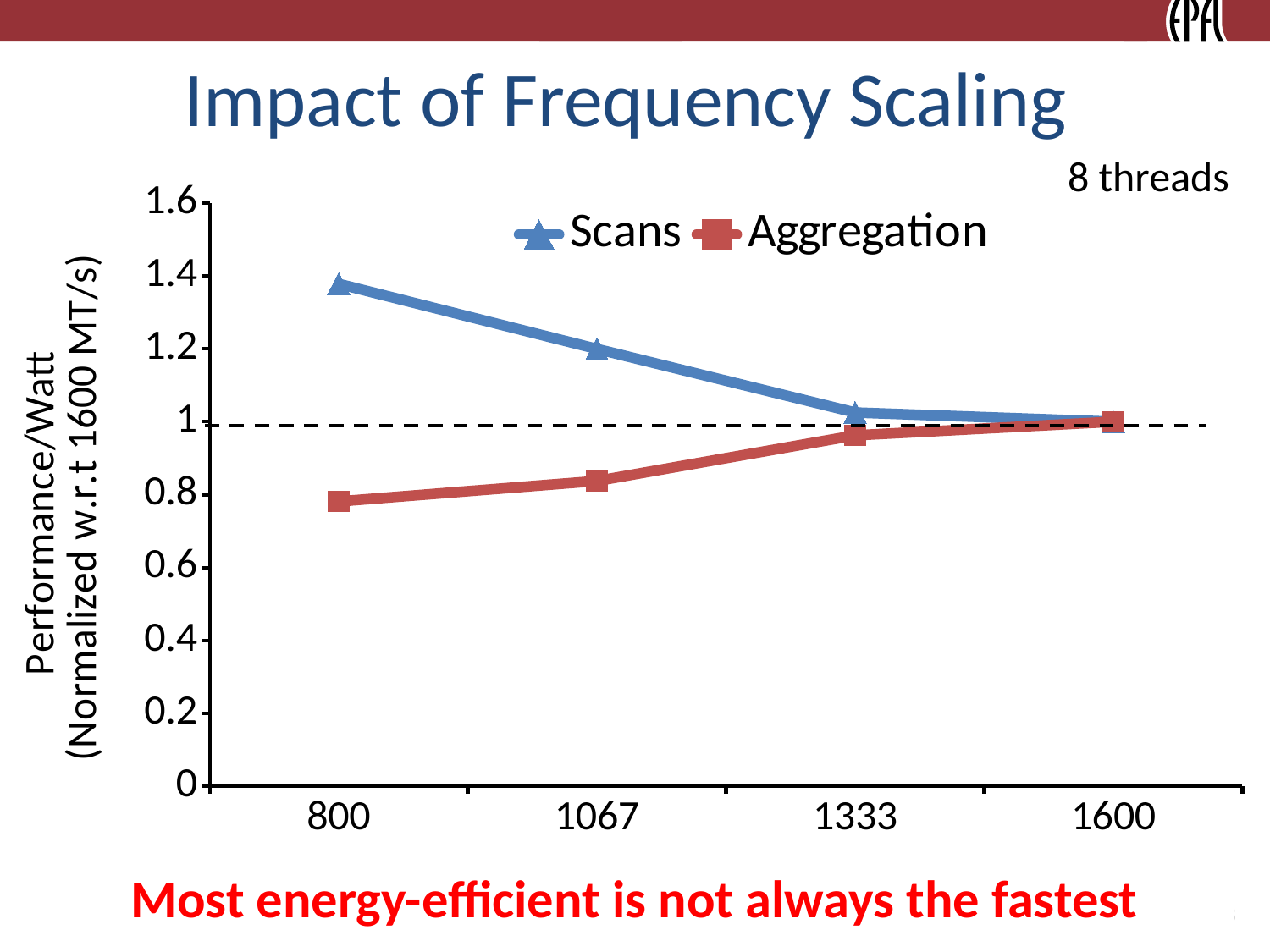
At which frequency is the Aggregation series lowest? 800 How many frequency points are plotted along the x axis? 4 Do the Scans values rise or fall as frequency increases from 800 to 1600? fall What kind of chart is shown on the slide? line chart Is the value for Aggregation at 1067 greater or less than 1? less What is the value of Scans at 1600? 1 At 800, which series has the larger value, Scans or Aggregation? Scans What is the title of the chart? Impact of Frequency Scaling At which frequency is the Scans series highest? 800 Is the value for Scans at 1067 greater or less than 1? greater How many series does the legend list? 2 Is the value for Scans at 800 greater or less than 1.2? greater